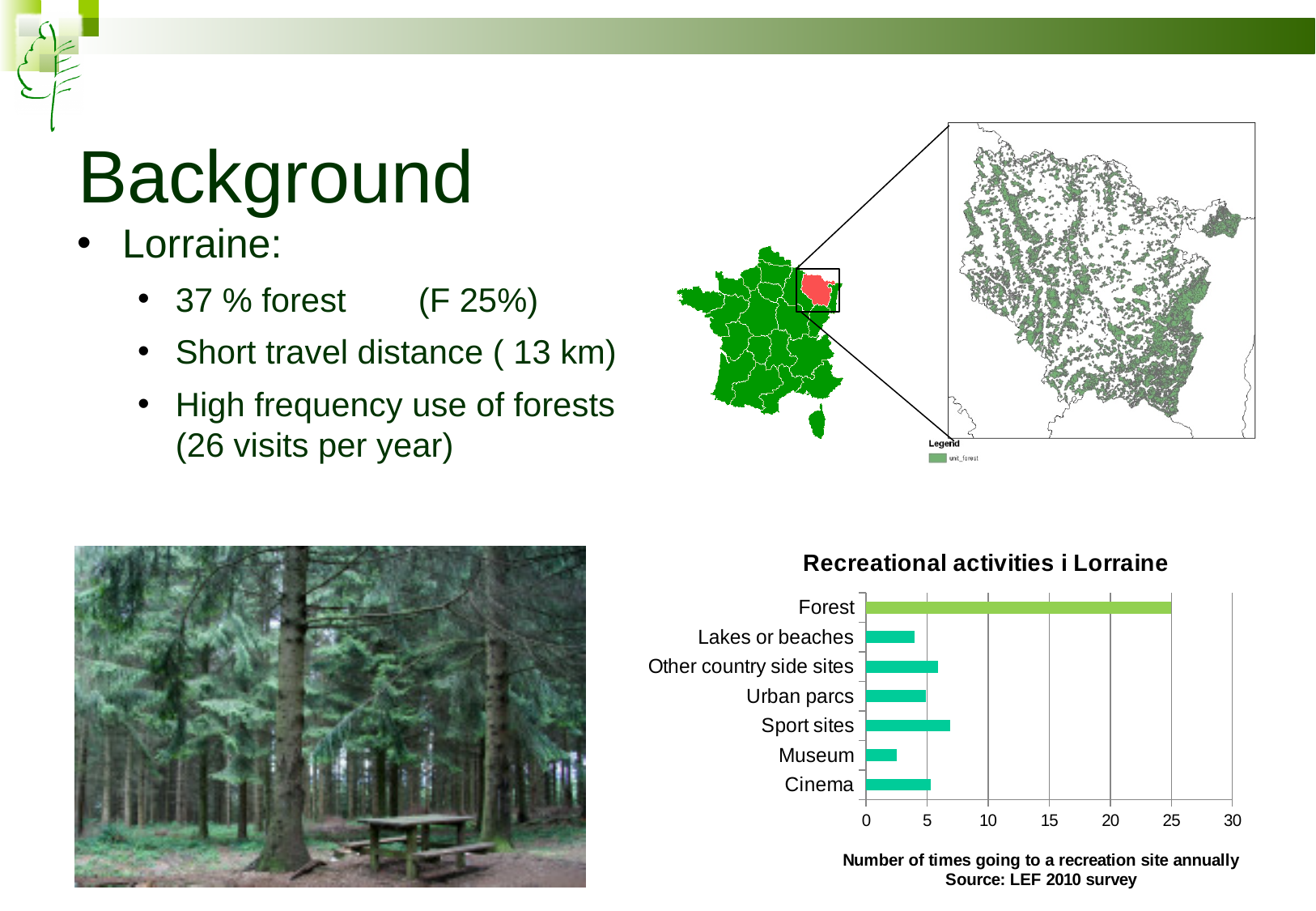
Which has a larger value, Sport sites or Lakes or beaches? Sport sites Is the value for Museum greater or less than 5? less Is the value for Lakes or beaches greater or less than 5? less What is the source cited below the chart? LEF 2010 survey Is the value for Forest greater or less than 20? greater How many categories are shown in the chart? 7 What kind of chart is shown on the slide? bar chart Which category has the lowest value in the chart? Museum What is the title of the chart on the slide? Recreational activities i Lorraine Which has a larger value, Forest or Cinema? Forest Which category has the highest value in the chart? Forest